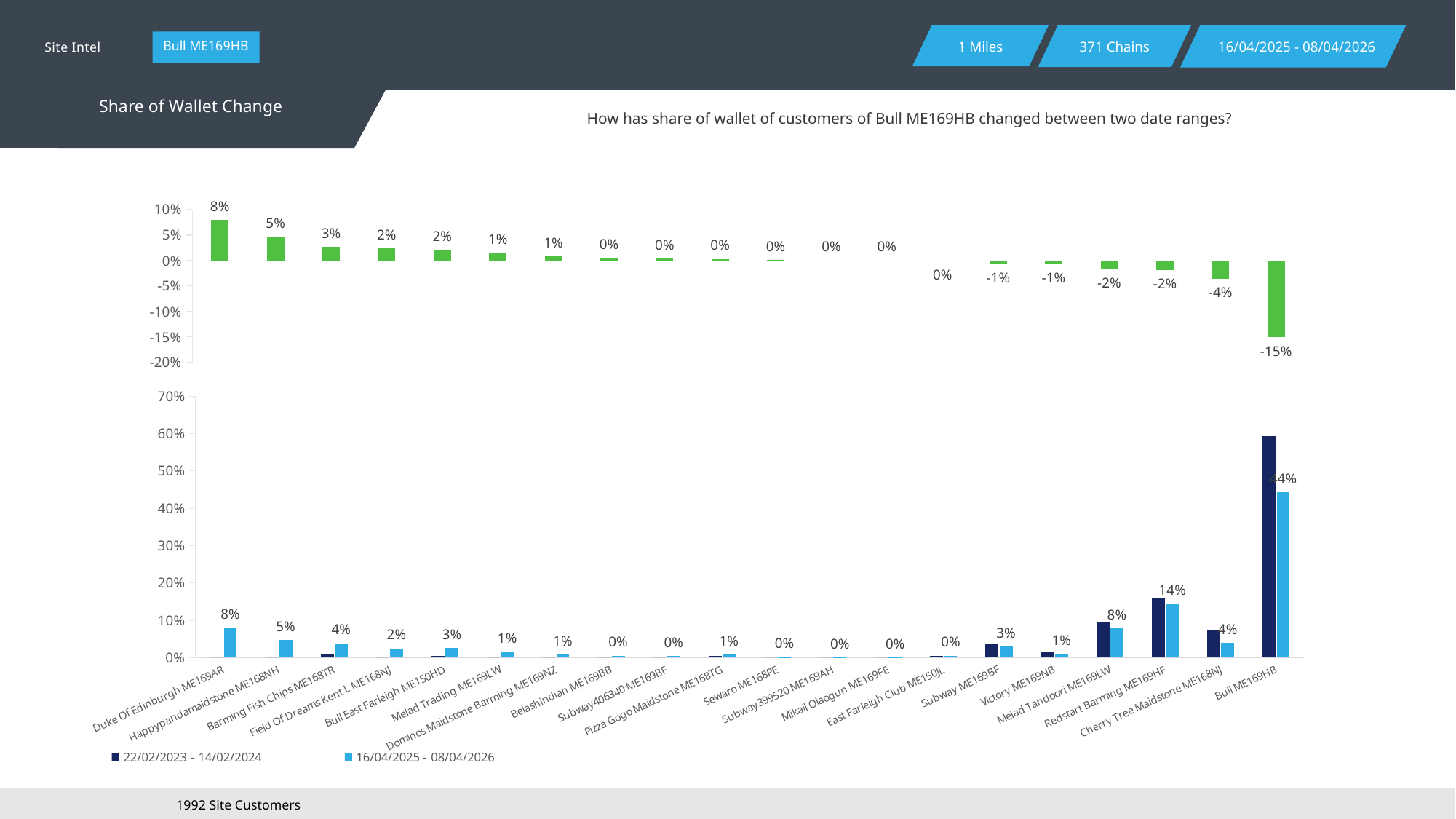
On the top chart (share of wallet change), what is the value of the first bar on the left? 8% On the top chart (share of wallet change), how many bars are plotted? 20 What kind of chart is the bottom chart? bar chart On the bottom chart, what is the difference between the labelled values for Bull ME169HB and Redstart Barming ME169HF? 30% On the bottom chart, what is the labelled value for Bull ME169HB? 44% On the bottom chart, what is the labelled value for Redstart Barming ME169HF? 14% On the bottom chart, what is the labelled value for Duke Of Edinburgh ME169AR? 8% On the top chart (share of wallet change), what is the value of the last bar on the right? -15% On the top chart (share of wallet change), do the values rise or fall from left to right? fall On the top chart (share of wallet change), what is the lowest value shown? -15% On the bottom chart, is the 22/02/2023 - 14/02/2024 value for Bull ME169HB greater or less than 50%? greater On the bottom chart, how many series does the legend list? 2